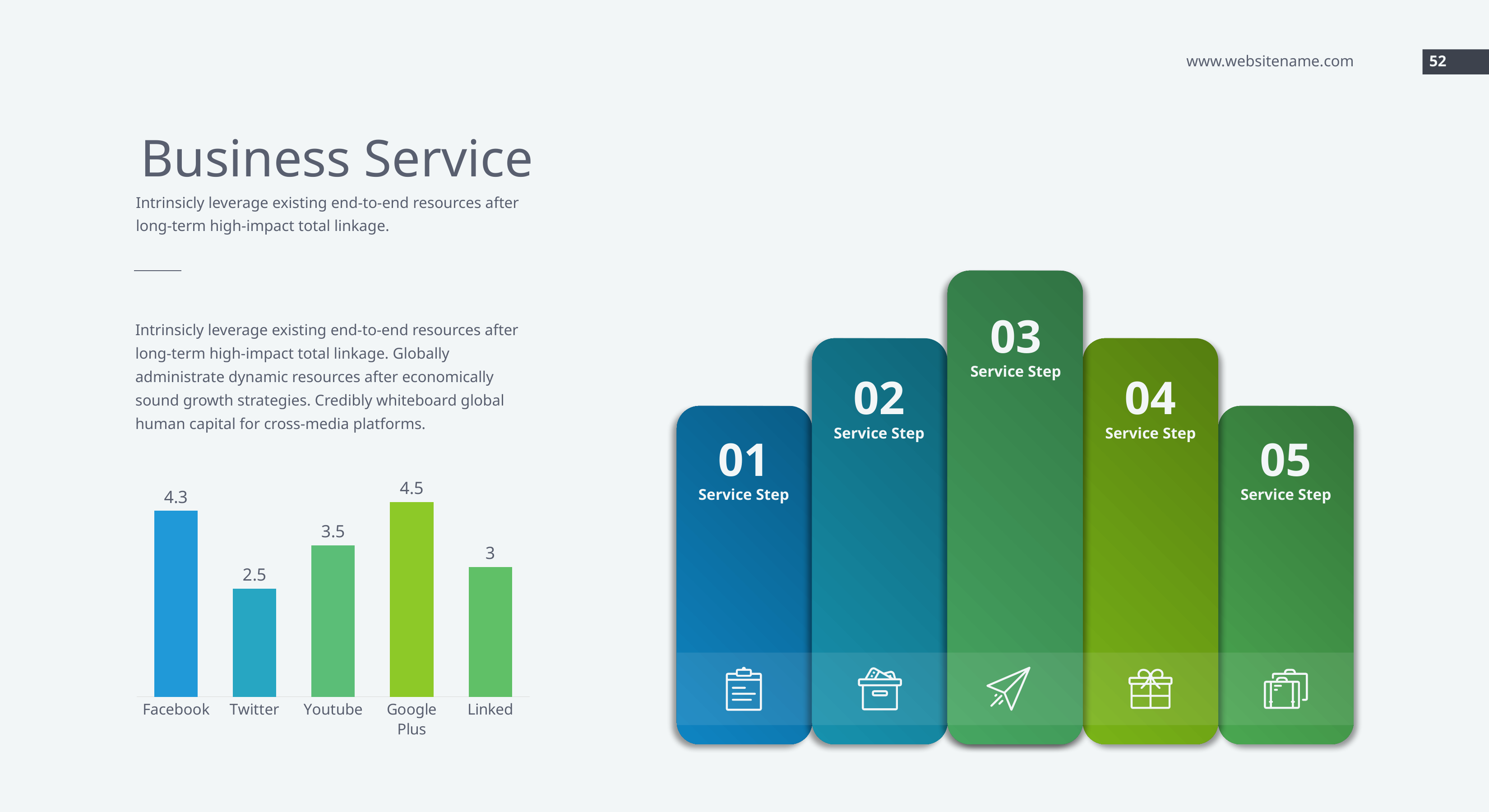
How many categories are shown in the bar chart? 5 What is the value for Facebook in the bar chart? 4.3 What is the value for Twitter in the bar chart? 2.5 What is the difference between the values for Youtube and Linked in the bar chart? 0.5 What is the value for Google Plus in the bar chart? 4.5 What kind of chart is shown on the left of the slide? Bar chart What is the value for Linked in the bar chart? 3 What is the value for Youtube in the bar chart? 3.5 Which is larger in the bar chart, the value for Facebook or the value for Youtube? Facebook Which category has the highest value in the bar chart? Google Plus What is the difference between the values for Google Plus and Twitter in the bar chart? 2 Which category has the lowest value in the bar chart? Twitter